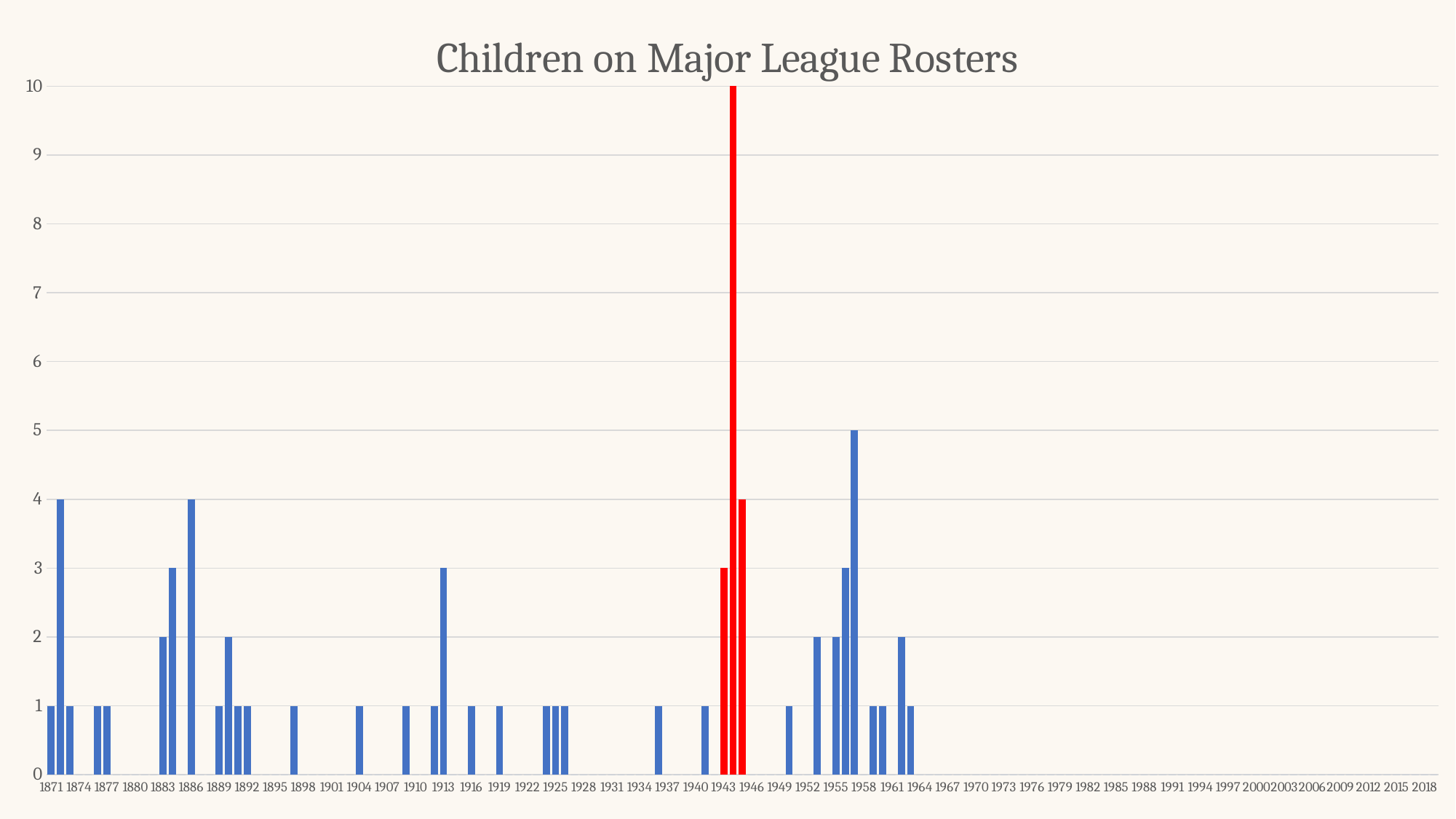
What is the value for 1883? 2 What colour is the tallest bar in the chart? red Which is larger, the value for 1886 or the value for 1958? 1886 What is the value for 1886? 4 What is the value for 1913? 3 What kind of chart is shown on the slide? bar chart What is the value for 1964? 0 Is the value for 1958 greater or less than 4? less What is the title of the chart? Children on Major League Rosters What is the value for 1958? 0 What is the difference between the value for 1958 and the value for 1913? 3 What is the highest value reached by any bar in the chart? 10